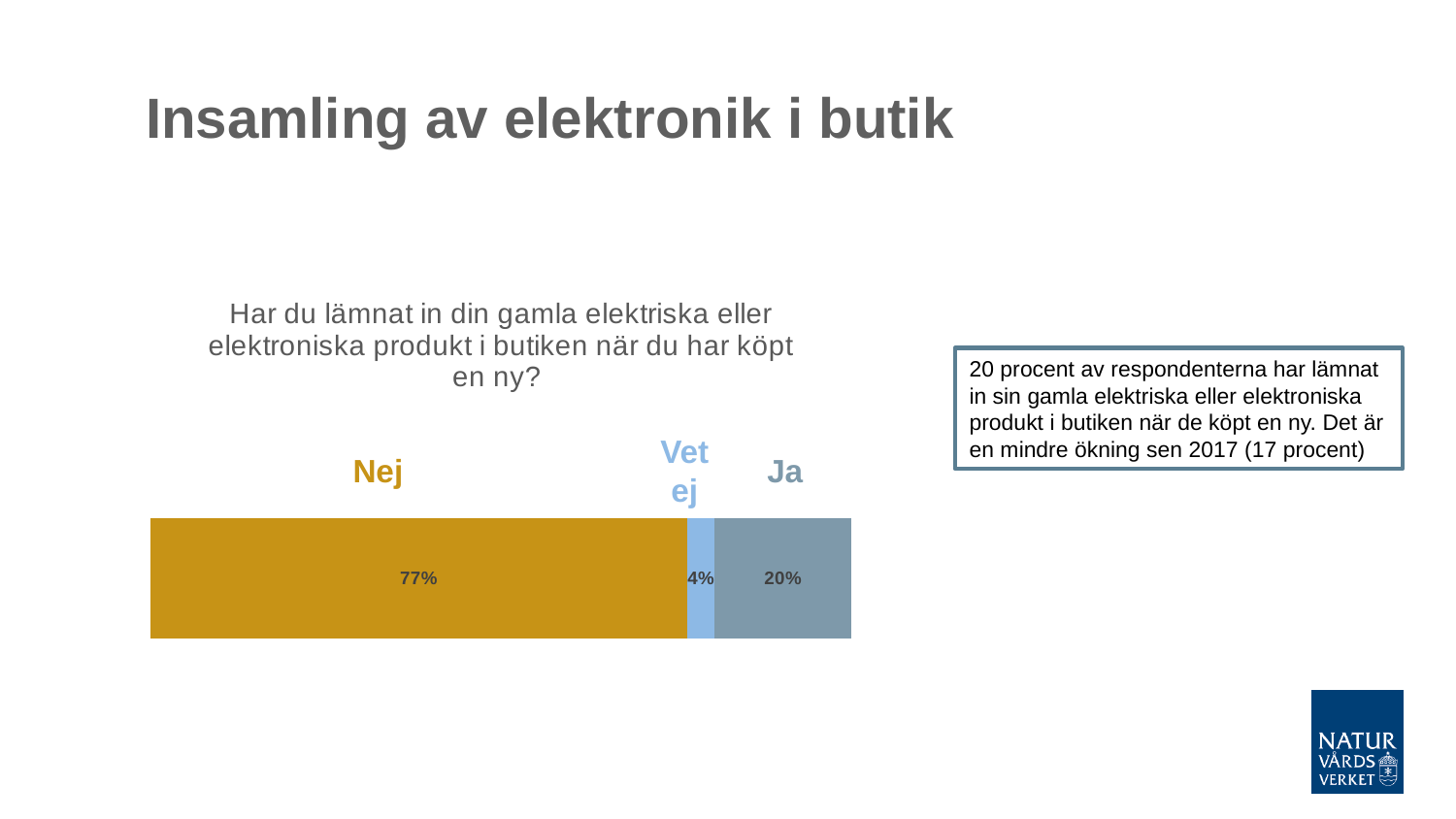
What percentage of respondents answered "Vet ej"? 4% What is the total of the three segments in the stacked bar? 101% Which response category has the smallest share? Vet ej Which response category is shown in the gold/yellow colour? Nej What is the difference in percentage points between "Ja" and "Vet ej"? 16 What kind of chart is shown on the slide? Stacked bar chart Which is larger, the share for "Ja" or the share for "Vet ej"? Ja What percentage of respondents answered "Nej"? 77% What is the difference in percentage points between "Nej" and "Ja"? 57 Which response category has the largest share? Nej How many response categories are shown in the bar? 3 What percentage of respondents answered "Ja"? 20%